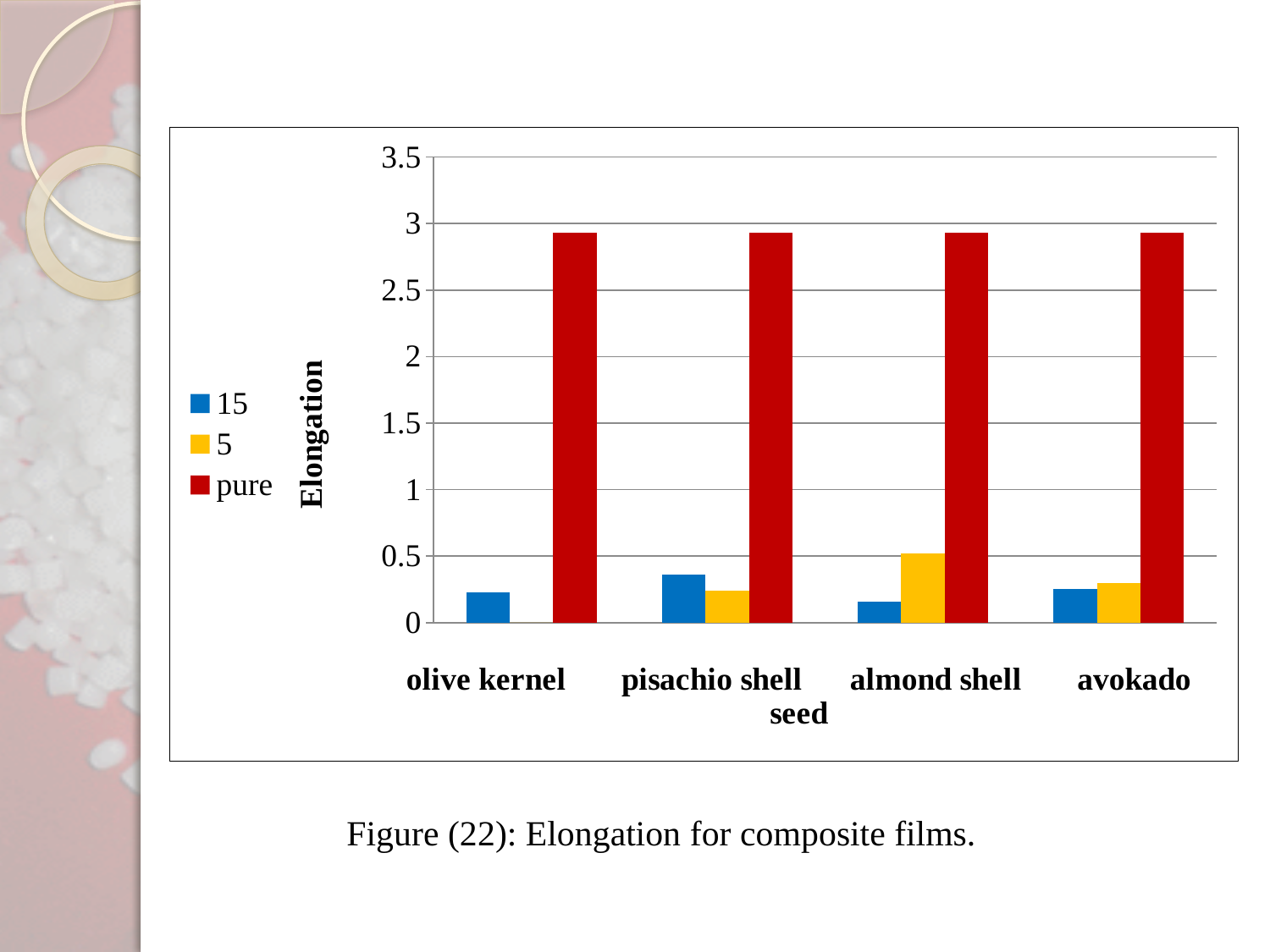
Which series is shown in red in the chart? pure Which category has the highest value for the 5 series? almond shell Which is larger at pisachio shell, the value for 15 or the value for 5? 15 Is the value for 15 at pisachio shell greater or less than 0.5? less Is the value for pure at olive kernel greater or less than 2.5? greater How many categories are shown on the x axis of the chart? 4 What kind of chart is shown on the slide? bar chart How many series does the chart's legend list? 3 What is the title of the vertical axis of the chart? Elongation Is the value for pure at avokado greater or less than 3? less Which is larger at almond shell, the value for 15 or the value for 5? 5